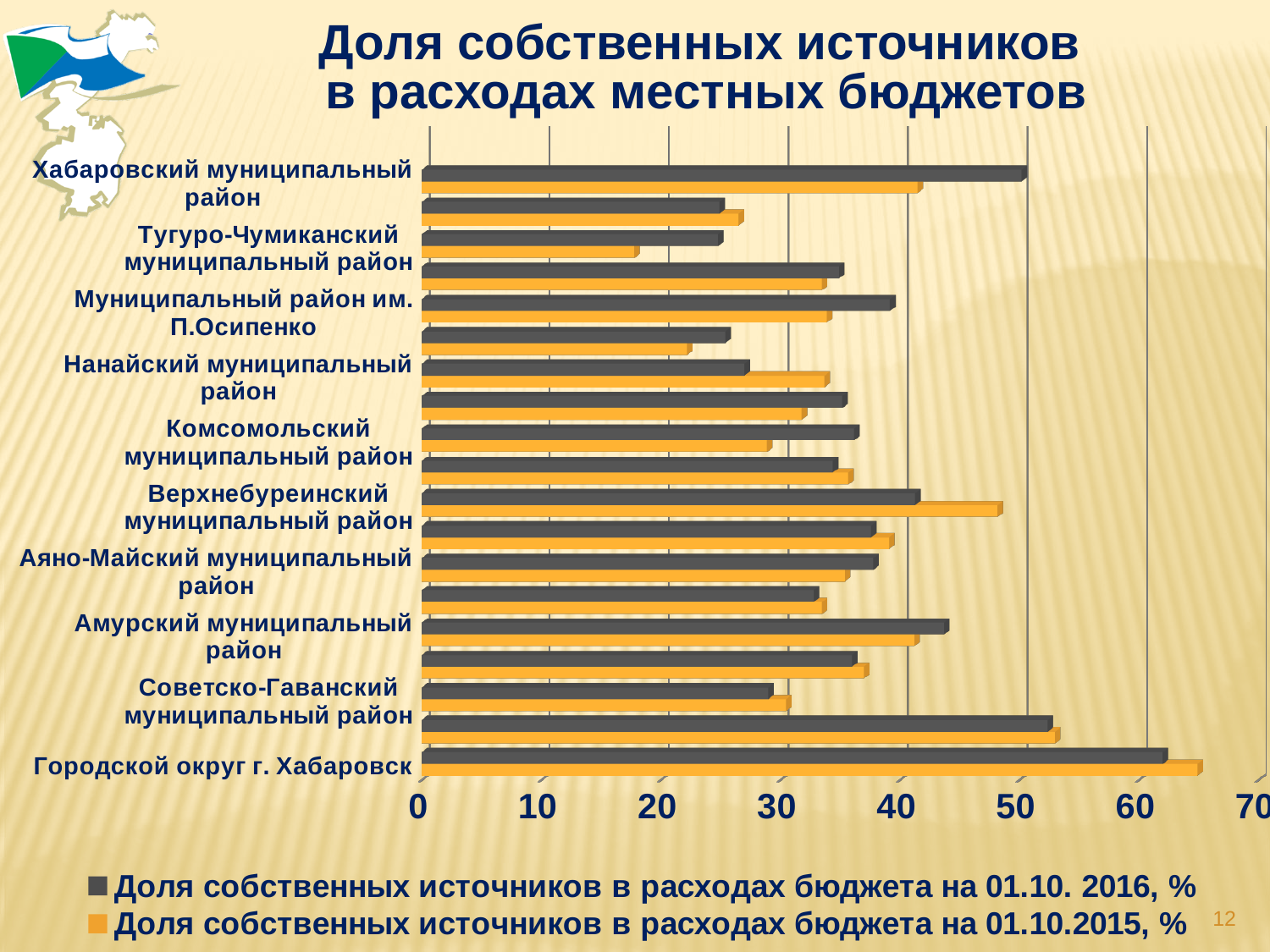
Is the value for Хабаровский муниципальный район on 01.10.2016 greater or less than 40? greater Which category has the highest value for the series 'Доля собственных источников в расходах бюджета на 01.10. 2016, %'? Городской округ г. Хабаровск For Хабаровский муниципальный район, which is larger: the value on 01.10.2016 or on 01.10.2015? 01.10.2016 Which category has the highest value for the series 'Доля собственных источников в расходах бюджета на 01.10.2015, %'? Городской округ г. Хабаровск For Городской округ г. Хабаровск, which is larger: the value on 01.10.2016 or on 01.10.2015? 01.10.2015 What is the title of the chart? Доля собственных источников в расходах местных бюджетов Is the value for Городской округ г. Хабаровск on 01.10.2016 greater or less than 60? greater What is the maximum value shown on the horizontal axis? 70 What kind of chart is shown on the slide? Bar chart Which series is shown in orange according to the legend? Доля собственных источников в расходах бюджета на 01.10.2015, % How many series does the legend list? 2